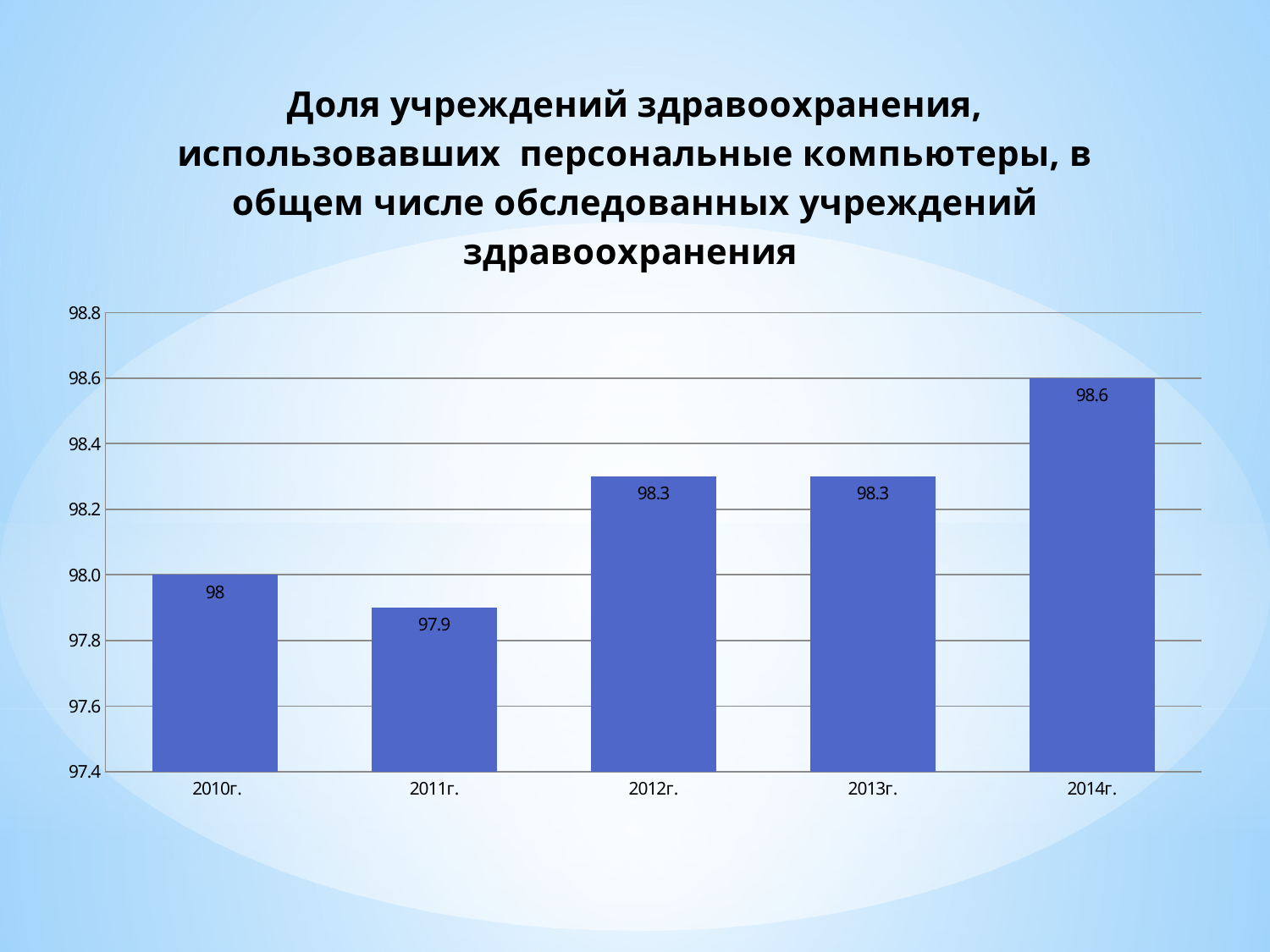
What is the value for 2010г.? 98 What is the value for 2014г.? 98.6 Which is larger, the value for 2010г. or the value for 2011г.? 2010г. What is the difference between the values for 2012г. and 2010г.? 0.3 Which year has the highest value? 2014г. What is the difference between the values for 2014г. and 2011г.? 0.7 Which year has the lowest value? 2011г. Do the values rise or fall from 2011г. to 2014г.? rise What kind of chart is shown on the slide? bar chart Is the value for 2013г. greater or less than 98.0? greater What is the value for 2011г.? 97.9 How many years are shown on the x axis? 5